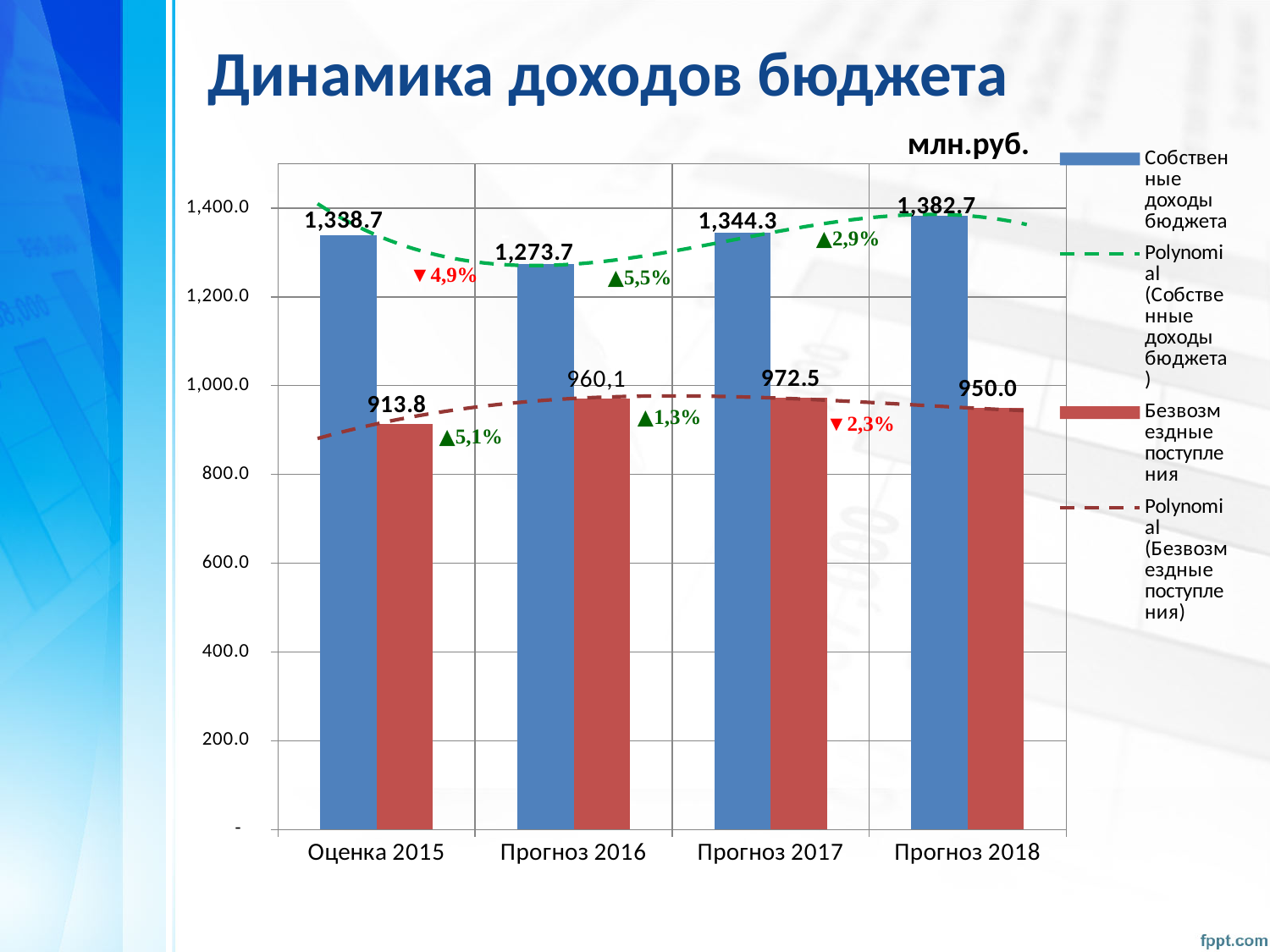
In which category is Безвозмездные поступления the highest? Прогноз 2017 How many entries does the legend list? 4 Which is larger: Безвозмездные поступления for Прогноз 2016 or for Прогноз 2018? Прогноз 2016 What is the value of Безвозмездные поступления for Прогноз 2017? 972.5 In which category is Собственные доходы бюджета the lowest? Прогноз 2016 In which category is Собственные доходы бюджета the highest? Прогноз 2018 What type of chart is shown on the slide? Bar chart How many categories are shown on the x axis? 4 What is the difference between Собственные доходы бюджета for Прогноз 2018 and Прогноз 2017? 38.4 What unit is indicated above the chart? млн.руб. What is the value of Безвозмездные поступления for Оценка 2015? 913.8 What is the value of Собственные доходы бюджета for Прогноз 2018? 1,382.7